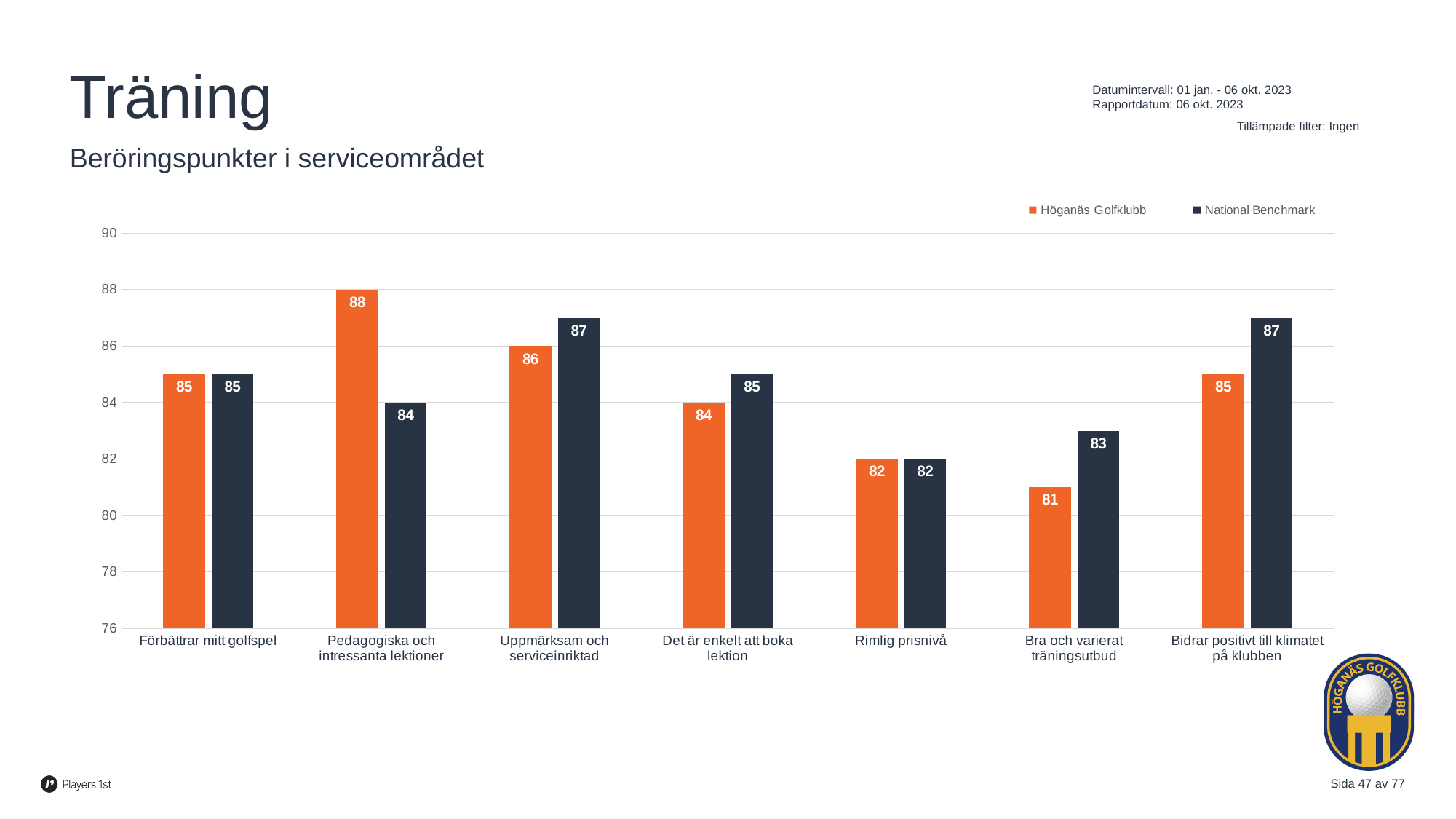
What is the difference between the Höganäs Golfklubb and National Benchmark values for "Pedagogiska och intressanta lektioner"? 4 For "Bidrar positivt till klimatet på klubben", which is larger: Höganäs Golfklubb or National Benchmark? National Benchmark What is the National Benchmark value for "Bra och varierat träningsutbud"? 83 Which category has the lowest Höganäs Golfklubb value? Bra och varierat träningsutbud What is the Höganäs Golfklubb value for "Rimlig prisnivå"? 82 Which series is shown in orange? Höganäs Golfklubb Which category has the lowest National Benchmark value? Rimlig prisnivå How many categories are shown on the x axis? 7 What kind of chart is shown on the slide? Bar chart What is the Höganäs Golfklubb value for "Pedagogiska och intressanta lektioner"? 88 Which category has the highest Höganäs Golfklubb value? Pedagogiska och intressanta lektioner How many series does the legend list? 2